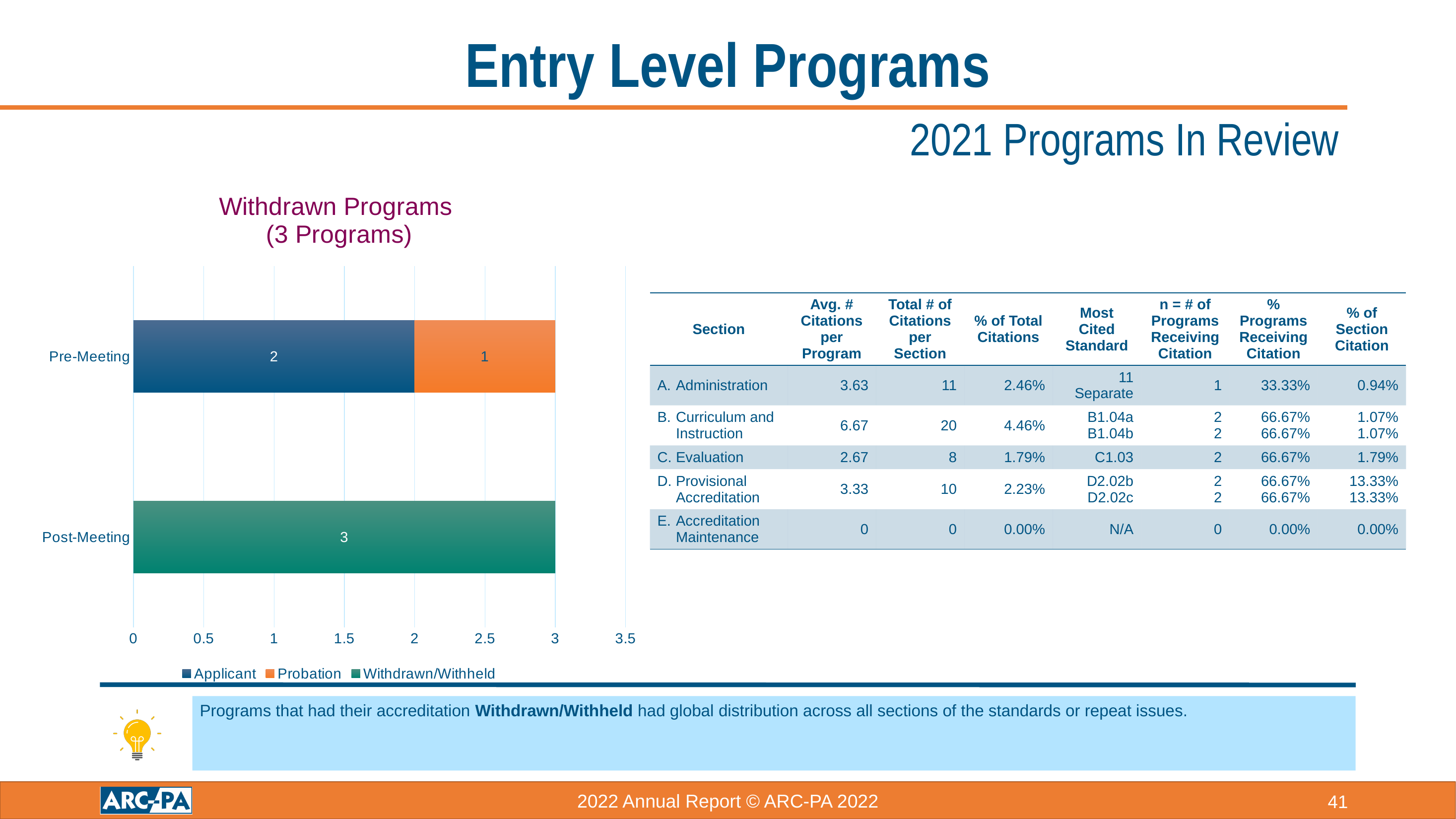
Is the Withdrawn/Withheld value for Post-Meeting greater or less than 2.5? greater What is the total of the Pre-Meeting stacked bar? 3 What kind of chart is shown on the slide? Bar chart Which series is shown in green in the chart legend? Withdrawn/Withheld What is the title of the chart? Withdrawn Programs (3 Programs) What is the difference between the Applicant value and the Probation value in the Pre-Meeting bar? 1 What is the value for Applicant in the Pre-Meeting bar? 2 How many categories are shown on the vertical axis of the chart? 2 What is the value for Probation in the Pre-Meeting bar? 1 How many series does the legend list? 3 Which is larger in the Pre-Meeting bar, Applicant or Probation? Applicant What is the value for Withdrawn/Withheld in the Post-Meeting bar? 3